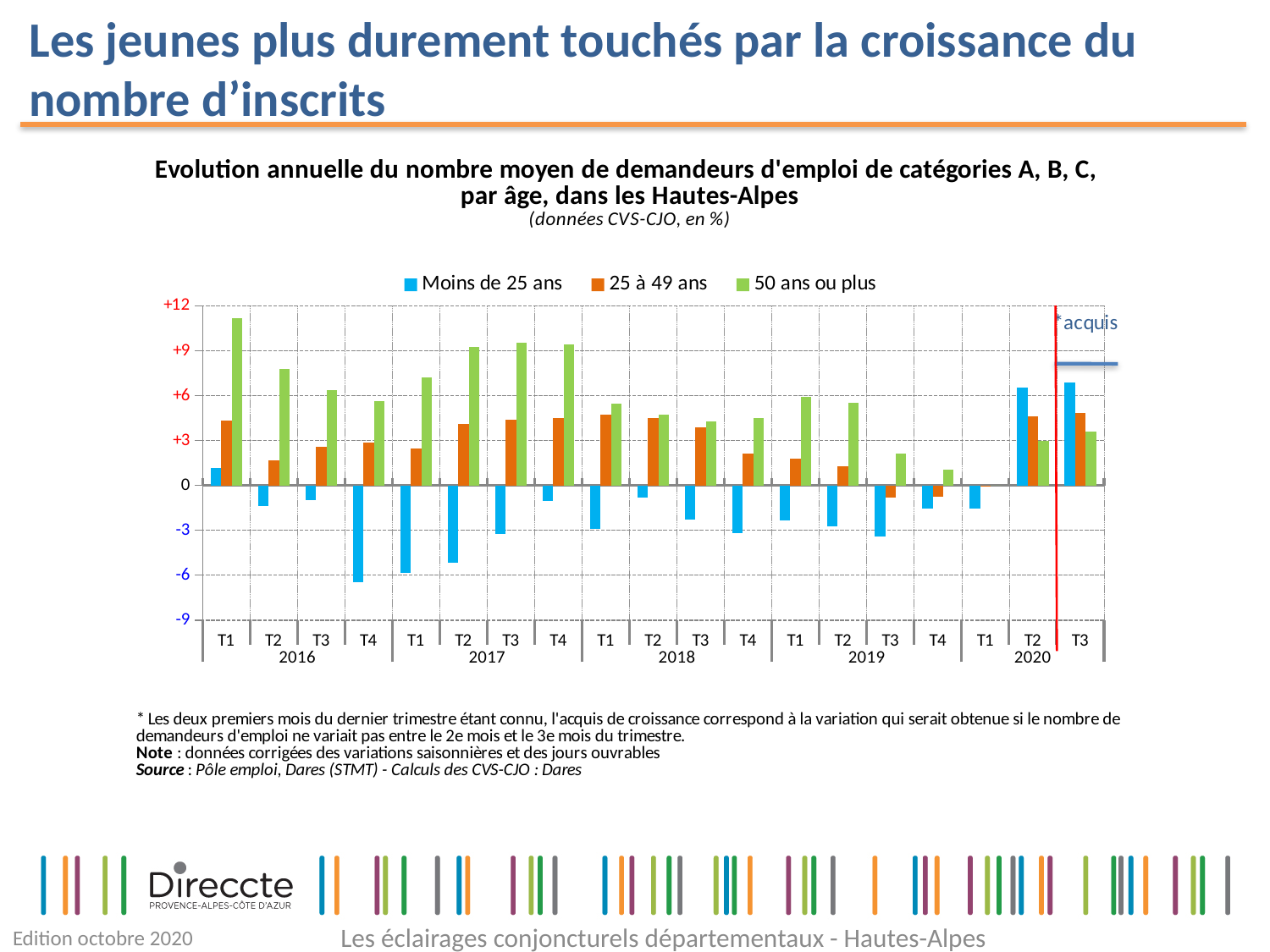
In T2 2020, which series has the larger value: 'Moins de 25 ans' or '50 ans ou plus'? Moins de 25 ans What are the three series named in the legend? Moins de 25 ans, 25 à 49 ans, 50 ans ou plus In which quarter is the value for 'Moins de 25 ans' the lowest? T4 2016 In T2 2017, which series has the larger value: '25 à 49 ans' or '50 ans ou plus'? 50 ans ou plus In which quarter is the value for '50 ans ou plus' the highest? T1 2016 How many series does the legend list? 3 How many quarters are plotted along the x axis? 19 Do the values for '50 ans ou plus' rise or fall from T1 2016 to T4 2016? fall What kind of chart is shown on the slide? bar chart Is the value for '25 à 49 ans' in T1 2018 greater or less than +3? greater Is the value for 'Moins de 25 ans' in T4 2016 greater or less than -3? less Is the value for '50 ans ou plus' in T1 2016 greater or less than +9? greater